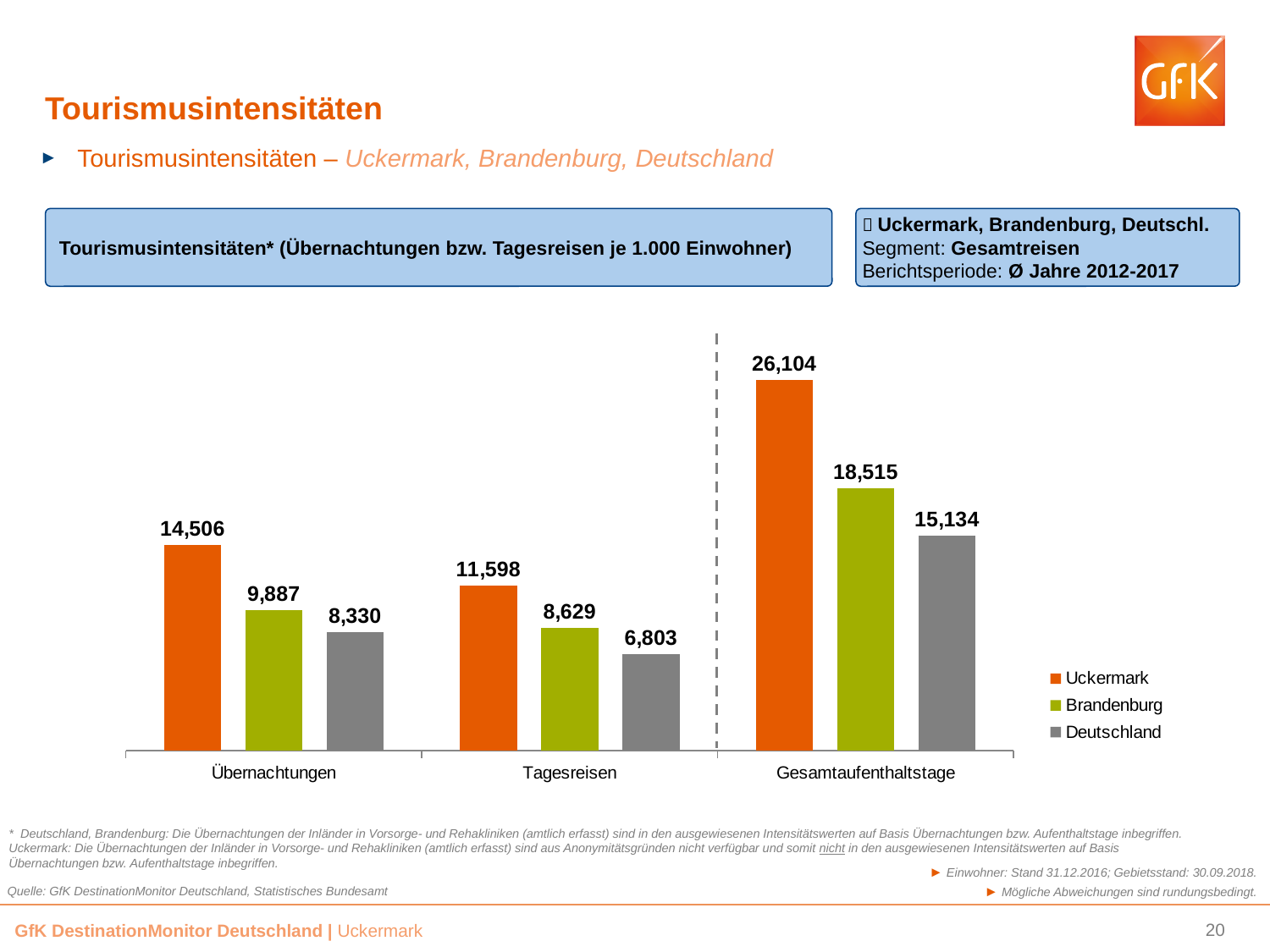
How many series does the legend list? 3 How many categories are shown on the x axis? 3 Which series has the lowest value in the Übernachtungen category? Deutschland What is the difference between the Brandenburg and Deutschland values for Tagesreisen? 1,826 Which series has the highest value in the Gesamtaufenthaltstage category? Uckermark What is the value for Brandenburg in the Gesamtaufenthaltstage category? 18,515 What is the value for Uckermark in the Übernachtungen category? 14,506 Which colour represents Brandenburg in the chart? Green What is the value for Deutschland in the Tagesreisen category? 6,803 Which is larger: the Uckermark value for Tagesreisen or the Brandenburg value for Übernachtungen? Uckermark value for Tagesreisen What is the difference between the Uckermark and Deutschland values for Gesamtaufenthaltstage? 10,970 What kind of chart is shown on the slide? Bar chart